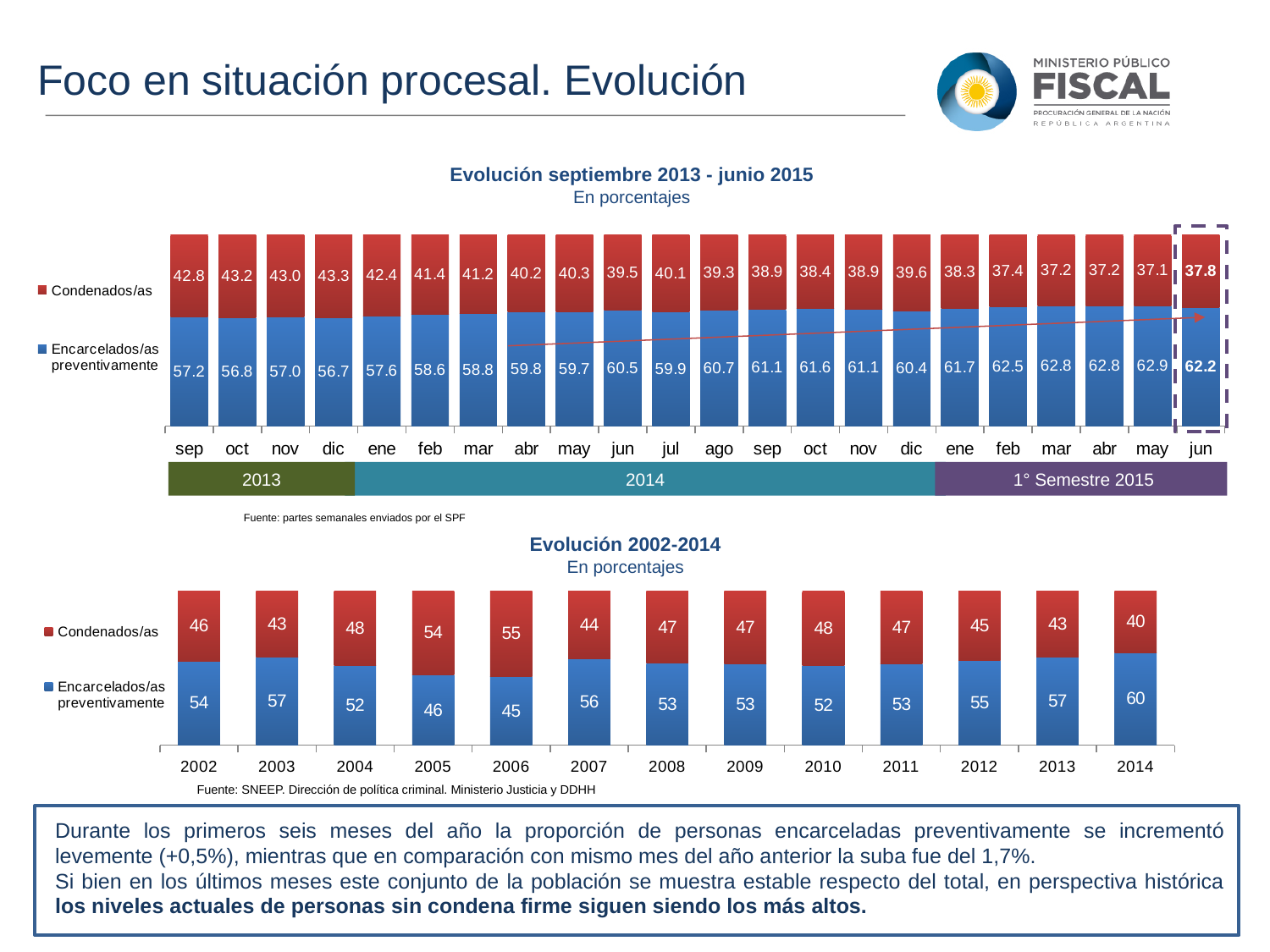
In the chart 'Evolución septiembre 2013 - junio 2015', what is the value for Encarcelados/as preventivamente in sep 2013? 57.2 How many years are shown in the chart 'Evolución 2002-2014'? 13 In the chart 'Evolución septiembre 2013 - junio 2015', does the value for Encarcelados/as preventivamente generally rise or fall from sep 2013 to jun 2015? Rise In the chart 'Evolución 2002-2014', what is the value for Encarcelados/as preventivamente in 2014? 60 In the chart 'Evolución 2002-2014', which year has the highest value for Encarcelados/as preventivamente? 2014 In the chart 'Evolución 2002-2014', what is the difference between the Encarcelados/as preventivamente values for 2014 and 2002? 6 In the chart 'Evolución septiembre 2013 - junio 2015', which is larger for Encarcelados/as preventivamente: dic 2013 or dic 2014? dic 2014 In the chart 'Evolución 2002-2014', which year has the lowest value for Encarcelados/as preventivamente? 2006 In the chart 'Evolución 2002-2014', what is the total of the stacked bar for 2005? 100 In the chart 'Evolución septiembre 2013 - junio 2015', what is the value for Condenados/as in jun 2015? 37.8 What kind of chart is 'Evolución septiembre 2013 - junio 2015'? Stacked bar chart How many series does the legend of the chart 'Evolución septiembre 2013 - junio 2015' list? 2